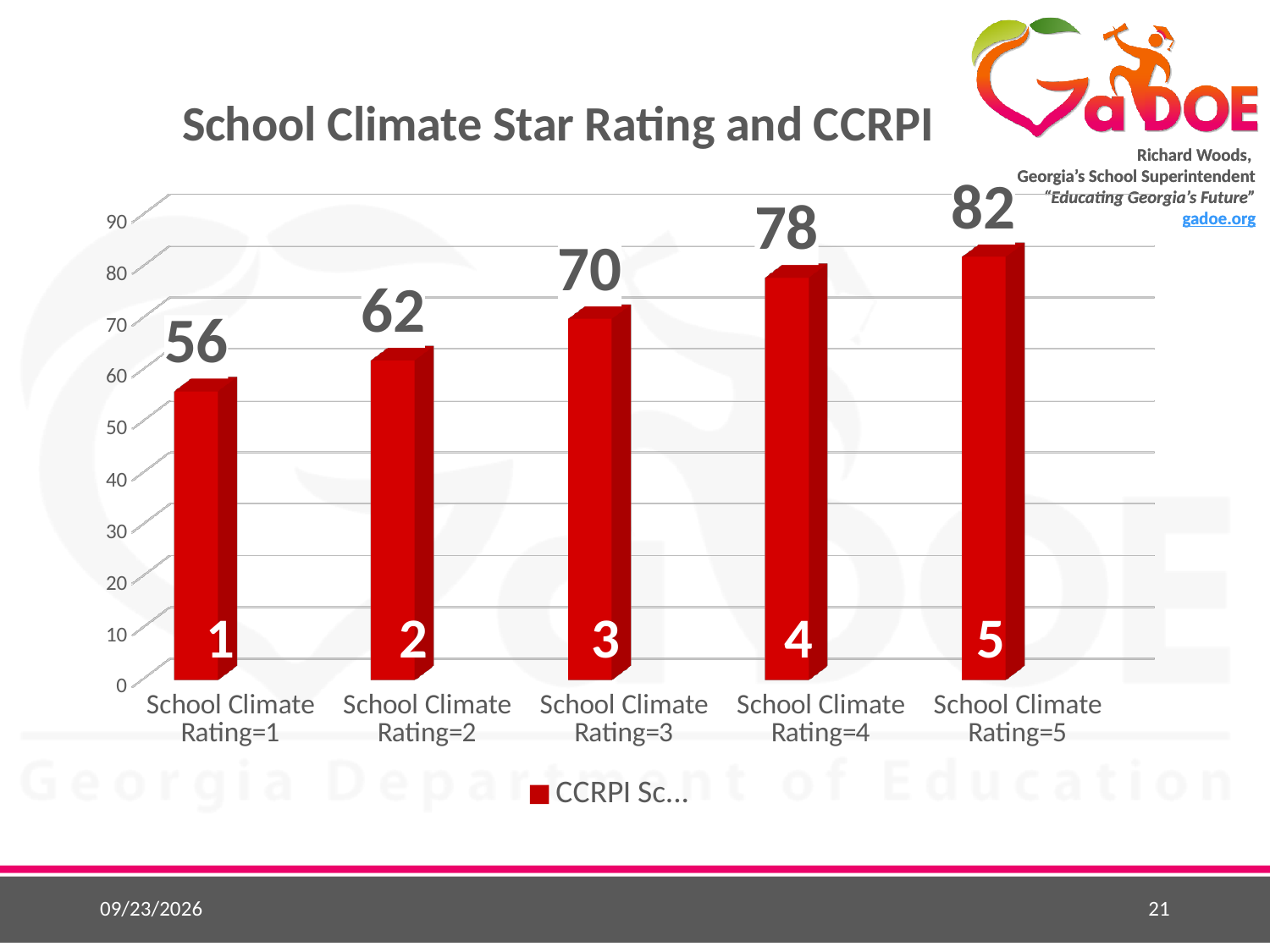
What is the CCRPI score for School Climate Rating=5? 82 Which School Climate Rating has the highest CCRPI score? School Climate Rating=5 Which has a higher CCRPI score, School Climate Rating=2 or School Climate Rating=4? School Climate Rating=4 How many School Climate Rating categories are shown in the chart? 5 Do the CCRPI scores rise or fall as the School Climate Rating increases from 1 to 5? rise What is the difference between the CCRPI scores for School Climate Rating=4 and School Climate Rating=2? 16 Is the CCRPI score for School Climate Rating=3 greater or less than 60? greater Which School Climate Rating has the lowest CCRPI score? School Climate Rating=1 What is the difference between the CCRPI scores for School Climate Rating=5 and School Climate Rating=1? 26 What is the CCRPI score for School Climate Rating=1? 56 What is the CCRPI score for School Climate Rating=3? 70 What kind of chart is shown on the slide? bar chart